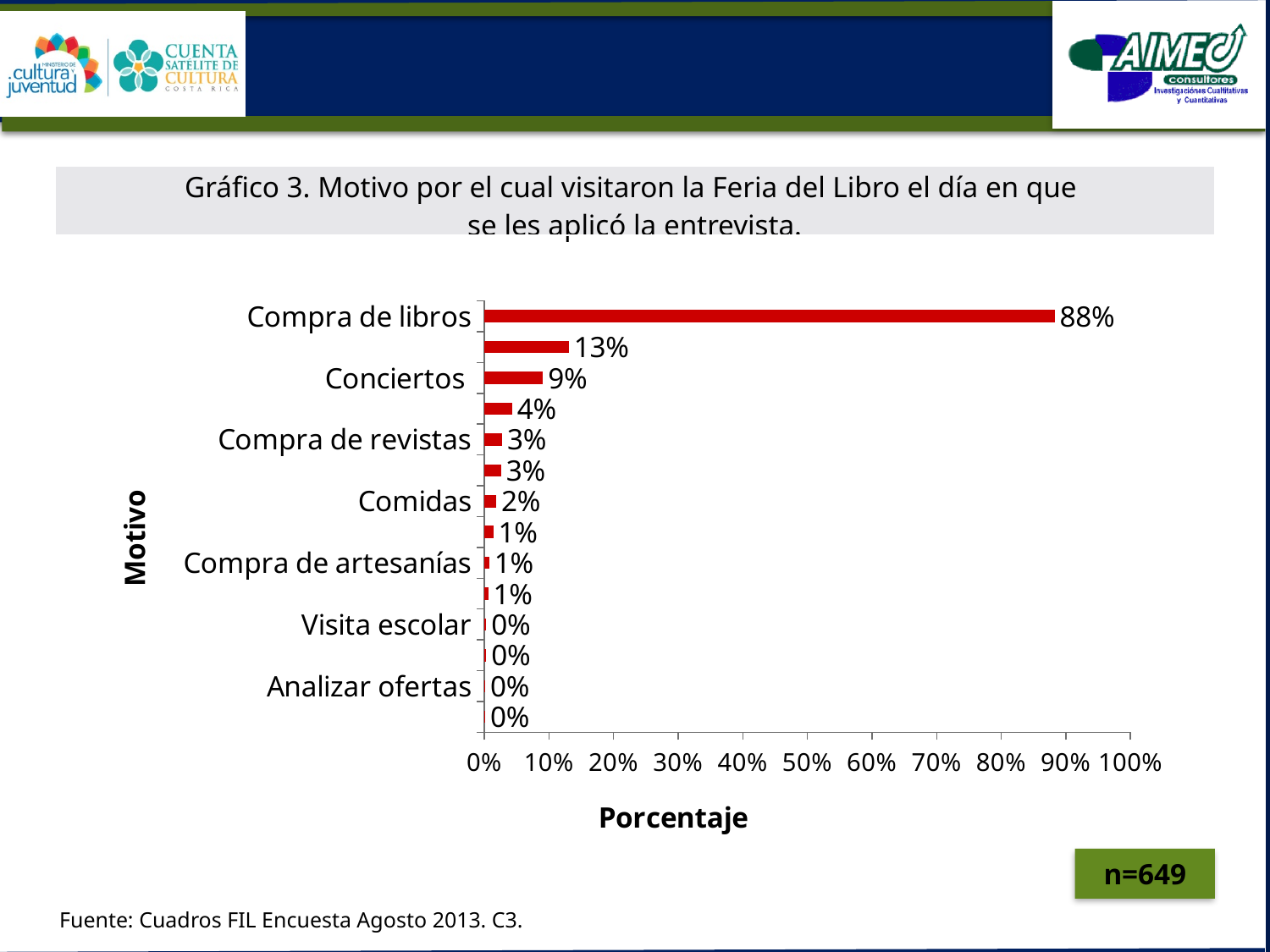
Which is larger, the value for Conciertos or the value for Comidas? Conciertos What is the value for Compra de artesanías? 1% What is the title of the horizontal axis? Porcentaje What is the value for Visita escolar? 0% What is the value for Comidas? 2% Is the value for Compra de libros greater or less than 80%? greater What is the value for Conciertos? 9% What kind of chart is shown on the slide? bar chart What is the value for Compra de revistas? 3% What is the value for Compra de libros? 88% Which motive has the highest value? Compra de libros What is the difference between the values for Compra de libros and Conciertos? 79 percentage points